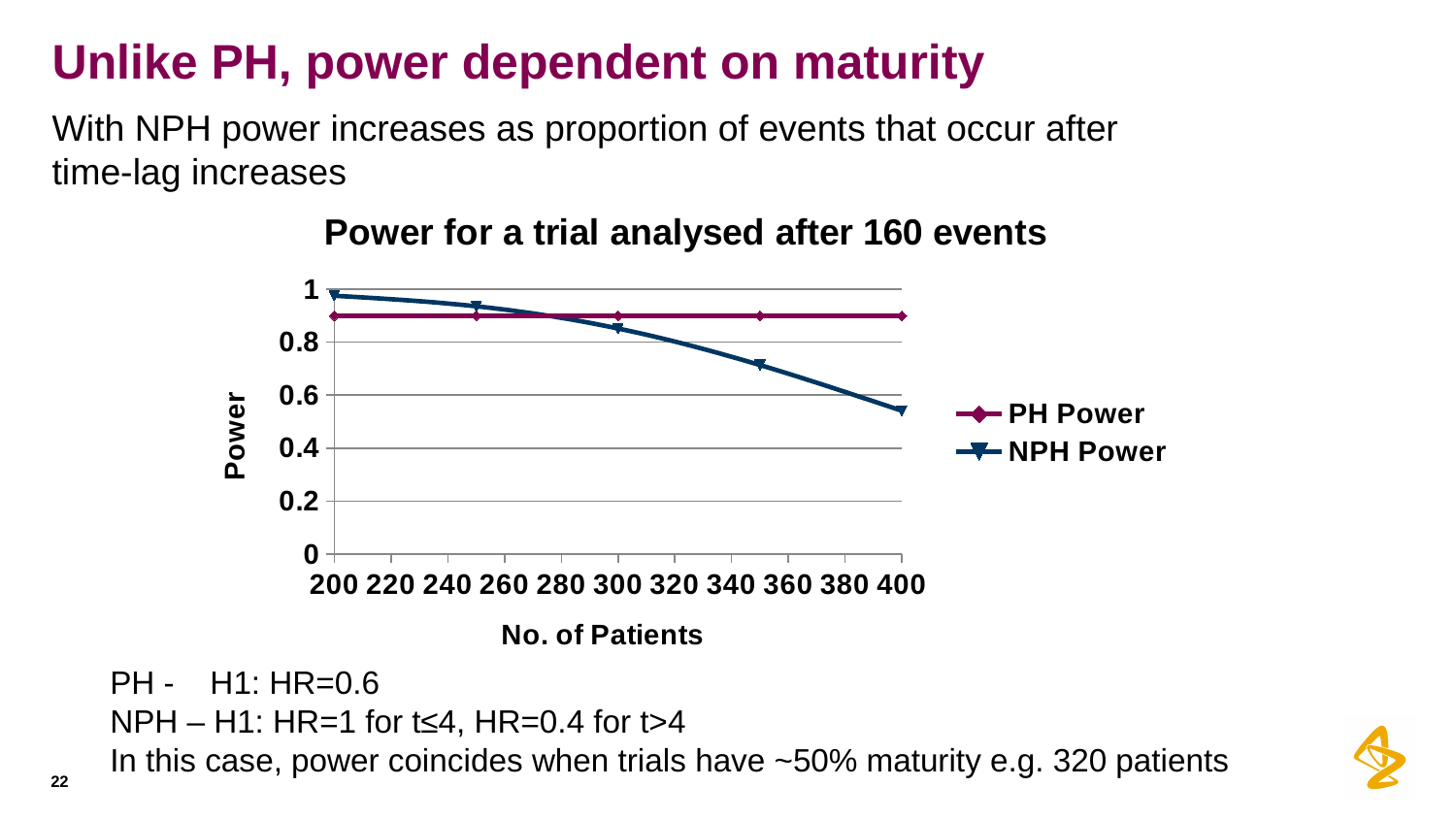
What is the label of the x axis? No. of Patients What kind of chart is shown on the slide? line chart Does NPH Power rise or fall as the number of patients increases? fall Is the NPH Power value at 350 patients greater or less than 0.8? less At 200 patients, which series has the larger value, PH Power or NPH Power? NPH Power What is the title of the chart? Power for a trial analysed after 160 events Is the NPH Power value at 400 patients greater or less than 0.6? less How many series does the legend list? 2 At 400 patients, which series has the larger value, PH Power or NPH Power? PH Power At which number of patients is NPH Power lowest? 400 Is the NPH Power value at 200 patients greater or less than 0.8? greater